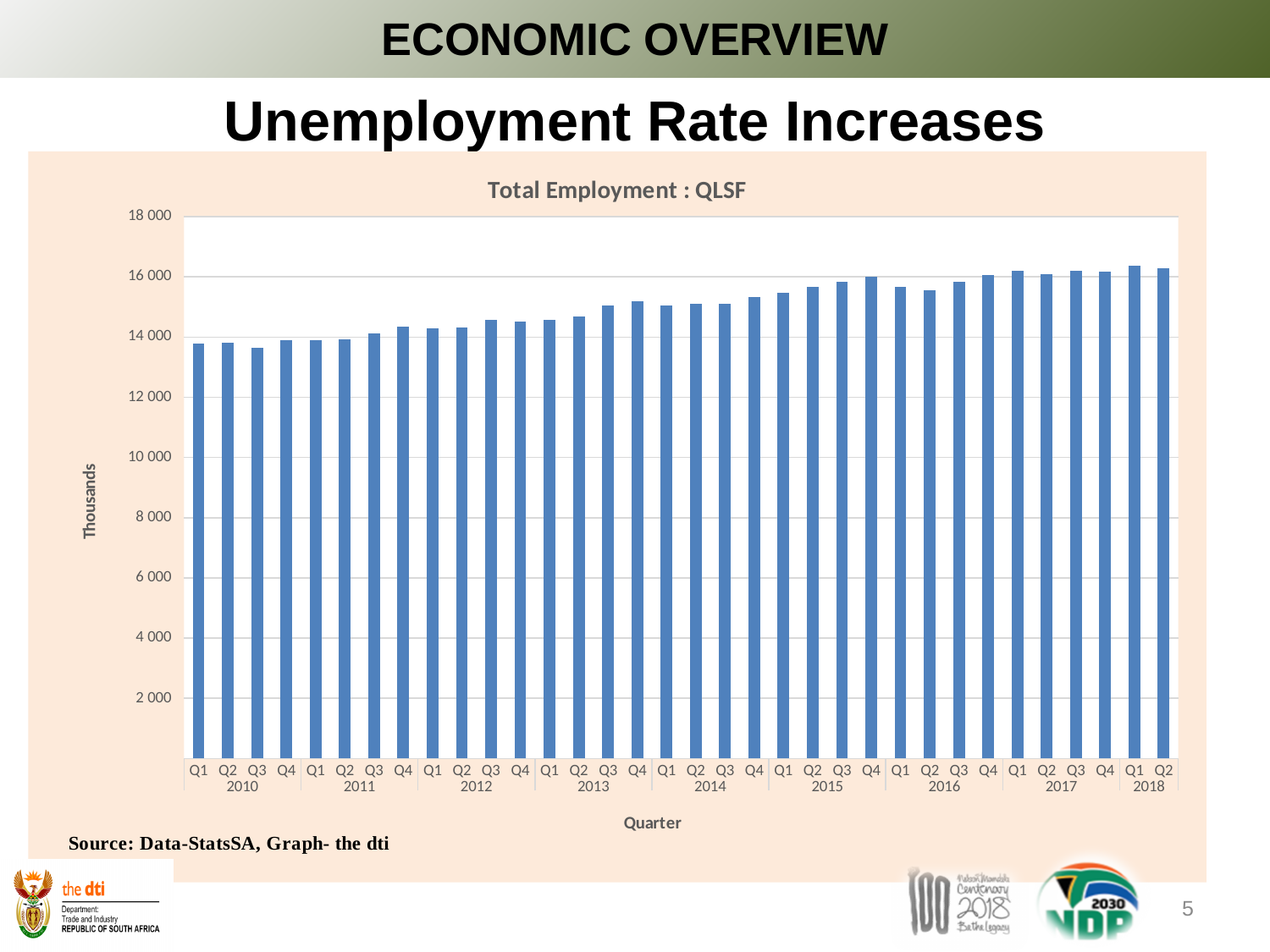
What kind of chart is shown on the slide? Bar chart Is the value for Q1 2010 greater or less than 14 000? less What is the label on the vertical axis of the chart? Thousands Do the values generally rise or fall from Q1 2010 to Q2 2018? Rise Which quarter has the highest total employment in the chart? Q1 2018 How many quarterly bars are plotted in the chart? 34 Which quarter has the lowest total employment in the chart? Q3 2010 What is the title of the chart? Total Employment : QLSF Which is larger, the value for Q1 2010 or the value for Q2 2018? Q2 2018 Is the value for Q4 2013 greater or less than 14 000? greater Is the value for Q1 2018 greater or less than 16 000? greater